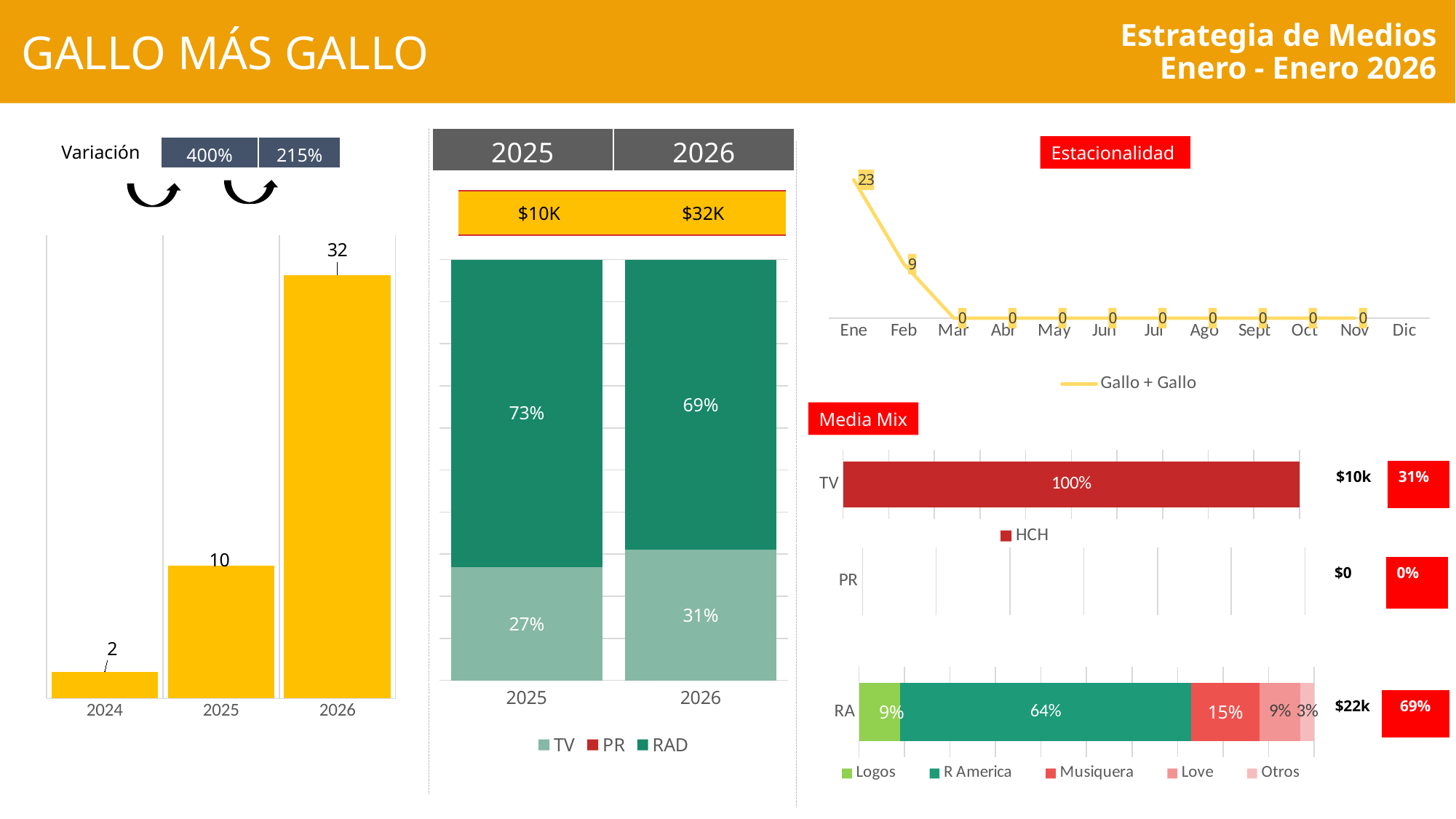
In the stacked bar chart in the middle of the slide, what is the RAD share for 2025? 73% In the bar chart on the left of the slide, which year has the lowest value? 2024 In the bar chart on the left of the slide, what is the difference between the values for 2026 and 2025? 22 In the stacked bar chart in the middle of the slide, how many series does the legend list? 3 In the bar chart on the left of the slide, do the values rise or fall from 2024 to 2026? rise In the Media Mix chart, what is the share for R America in the RA bar? 64% In the stacked bar chart in the middle of the slide, what is the TV share for 2026? 31% In the Estacionalidad line chart, which month has the highest value? Ene In the Media Mix chart, which is larger in the RA bar, Musiquera or Otros? Musiquera In the bar chart on the left of the slide, how many years are shown? 3 In the bar chart on the left of the slide, what is the value for 2026? 32 In the Estacionalidad line chart, what is the value for Ene? 23